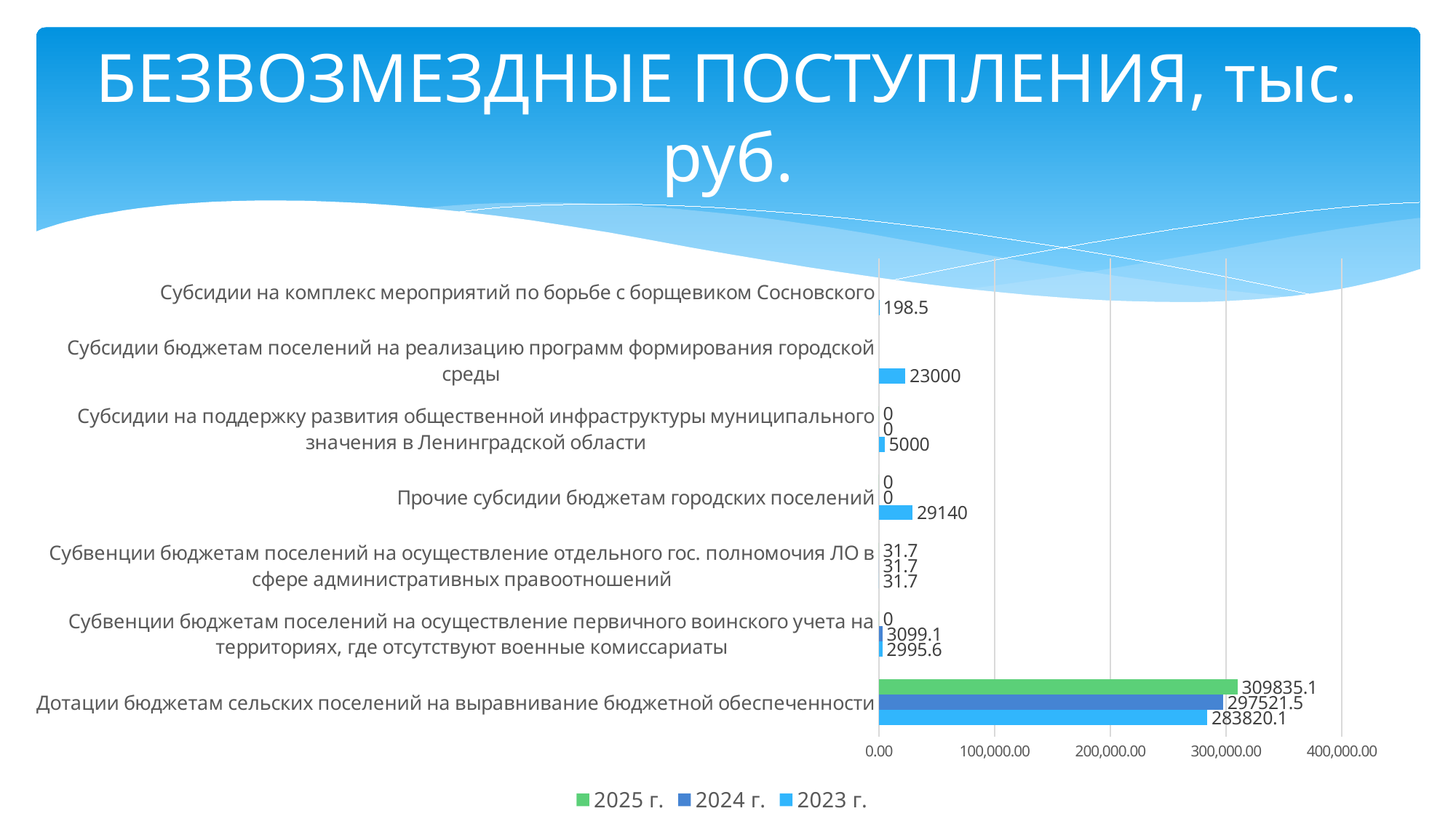
What is the 2025 г. value for Дотации бюджетам сельских поселений на выравнивание бюджетной обеспеченности? 309835.1 What is the value for Субсидии на комплекс мероприятий по борьбе с борщевиком Сосновского? 198.5 Which category has the highest values on the chart? Дотации бюджетам сельских поселений на выравнивание бюджетной обеспеченности What is the 2023 г. value for Прочие субсидии бюджетам городских поселений? 29140 How many categories are shown on the chart? 7 How many series does the legend list? 3 For Субвенции бюджетам поселений на осуществление первичного воинского учета, which is larger: the 2024 г. value or the 2023 г. value? 2024 г. What is the 2024 г. value for Субвенции бюджетам поселений на осуществление первичного воинского учета на территориях, где отсутствуют военные комиссариаты? 3099.1 What kind of chart is shown on the slide? bar chart What is the 2023 г. value for Дотации бюджетам сельских поселений на выравнивание бюджетной обеспеченности? 283820.1 Which series is shown in green in the legend? 2025 г. What is the difference between the 2025 г. and 2024 г. values for Дотации бюджетам сельских поселений на выравнивание бюджетной обеспеченности? 12313.6